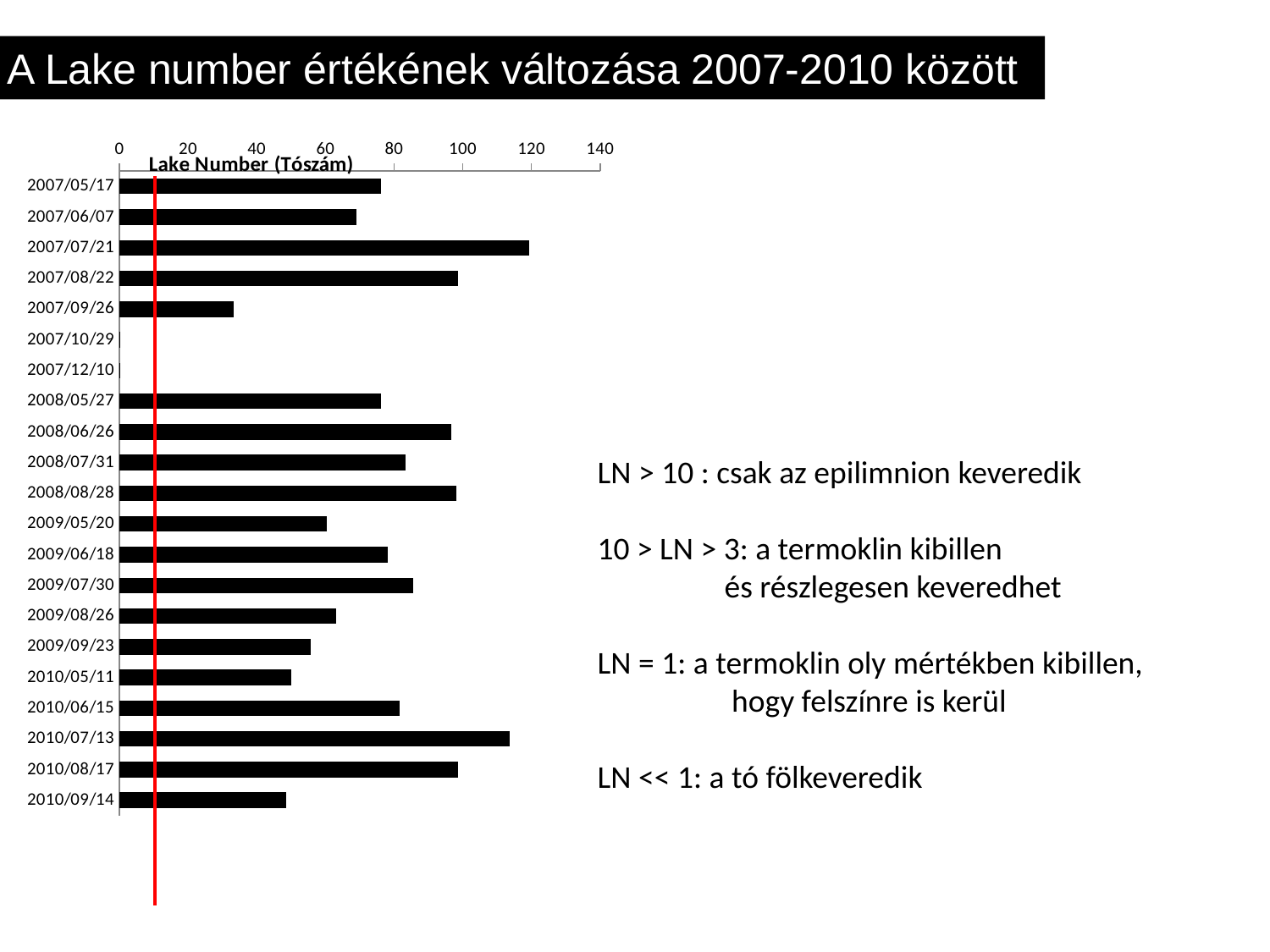
Which is larger, the value for 2008/06/26 or the value for 2009/09/23? 2008/06/26 Which is larger, the value for 2010/07/13 or the value for 2010/09/14? 2010/07/13 How many dates (categories) are listed on the chart's vertical axis? 21 Is the value for 2010/07/13 greater or less than 100? greater Is the value for 2007/09/26 greater or less than 40? less Is the value for 2007/08/22 greater or less than 80? greater What kind of chart is shown on the slide? bar chart Which date has the highest Lake Number value? 2007/07/21 What is the title of the chart? Lake Number (Tószám) At what value on the x axis is the red vertical line drawn? 10